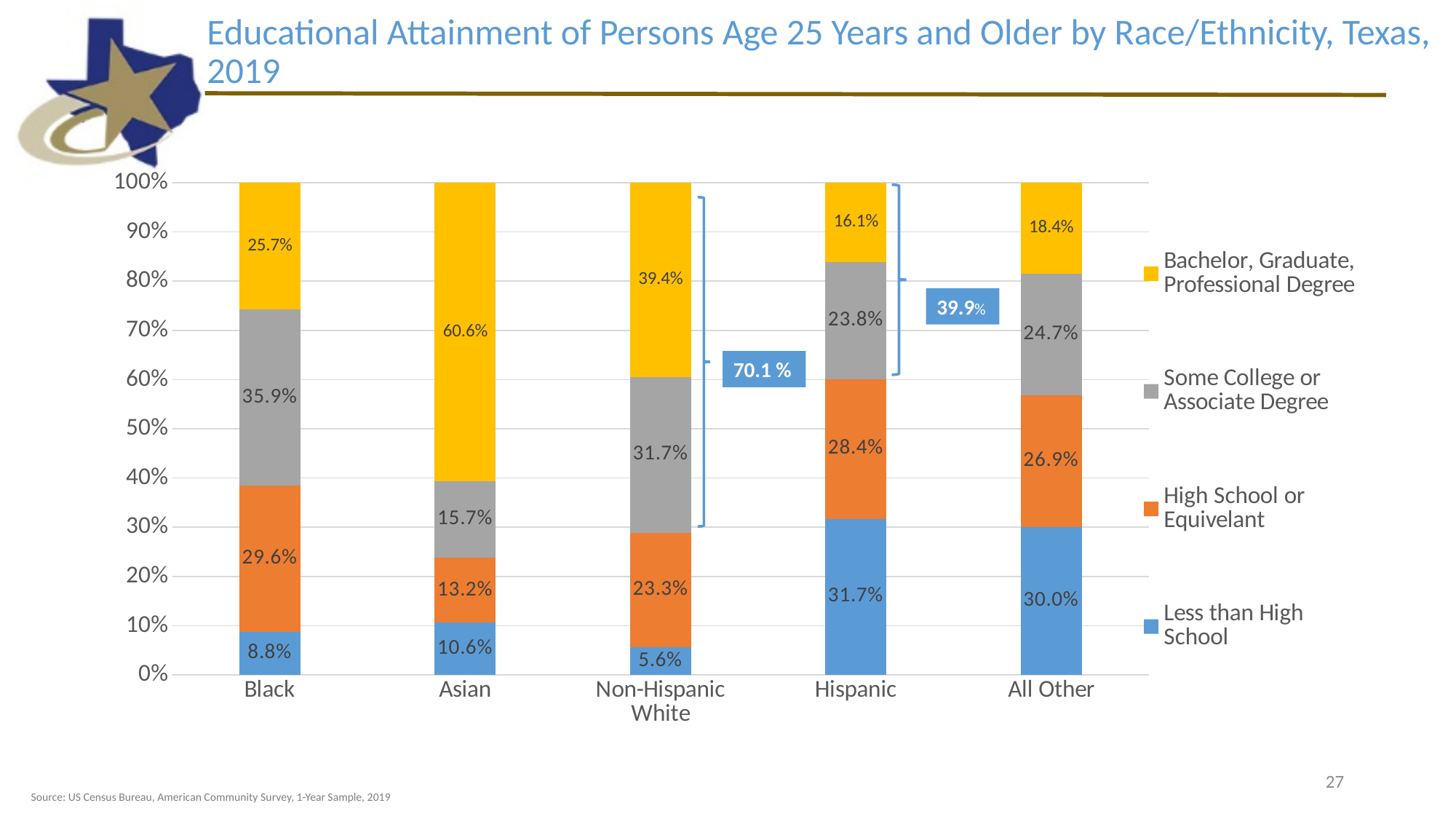
What percentage of Asian persons age 25 and older have a Bachelor, Graduate, or Professional Degree? 60.6% Which race/ethnicity group has the lowest Less than High School share? Non-Hispanic White What is the Less than High School share for Hispanic persons? 31.7% How many series does the legend list? 4 What is the difference between the Bachelor, Graduate, Professional Degree shares for Asian and Hispanic persons? 44.5 percentage points What is the High School or Equivalent share for Non-Hispanic White persons? 23.3% Which is larger: the High School or Equivalent share for Black persons or for Hispanic persons? Black Which race/ethnicity group has the highest share with a Bachelor, Graduate, or Professional Degree? Asian How many race/ethnicity categories are shown on the x axis? 5 What kind of chart is shown on the slide? Stacked bar chart What colour represents the Less than High School series? Blue What is the Some College or Associate Degree share for Black persons? 35.9%